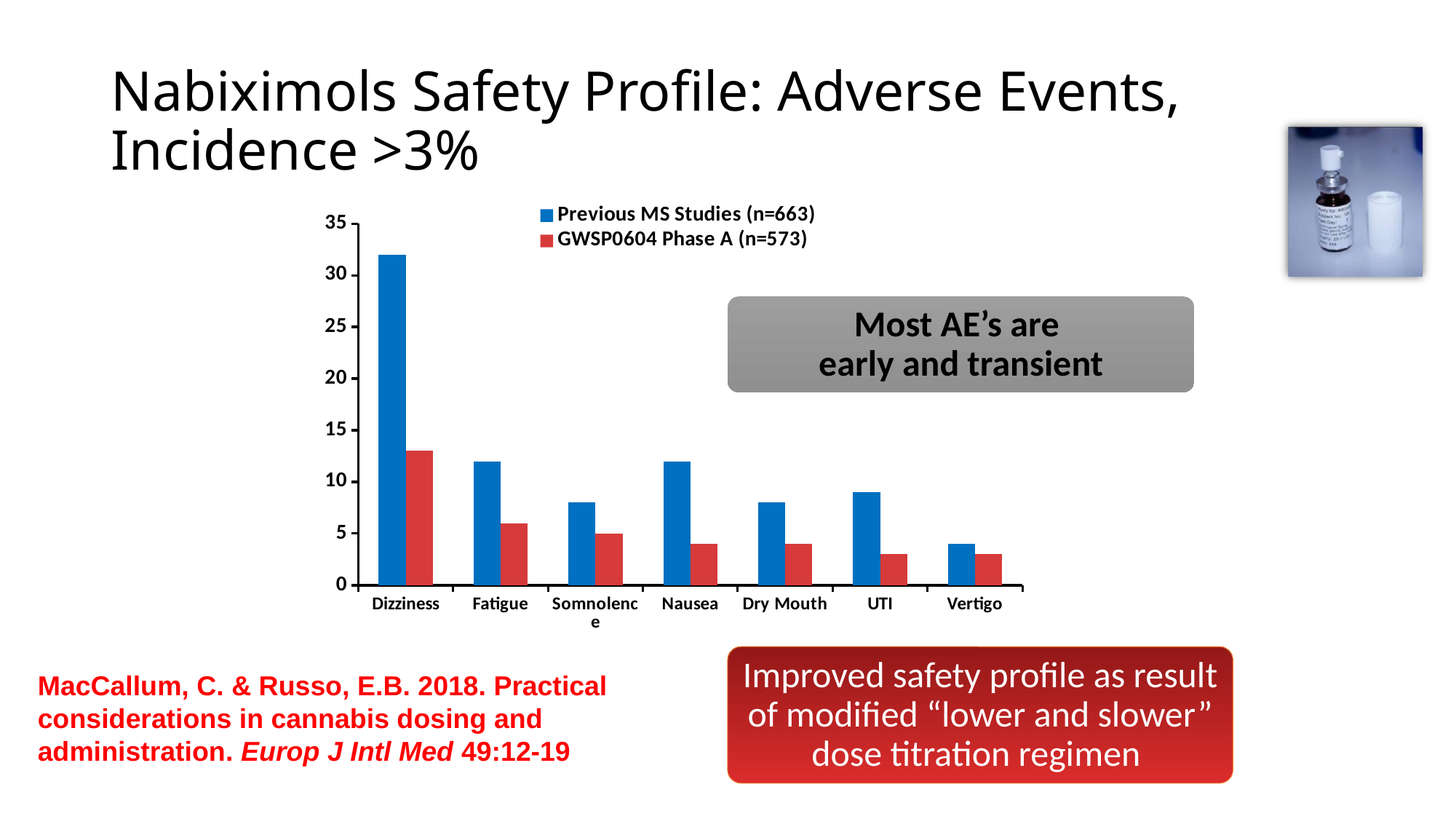
Which colour represents GWSP0604 Phase A (n=573) in the legend? red For Dizziness, which series has the larger value: Previous MS Studies (n=663) or GWSP0604 Phase A (n=573)? Previous MS Studies (n=663) Is the value for Dizziness in GWSP0604 Phase A (n=573) greater or less than 10? greater Which adverse event has the lowest value for Previous MS Studies (n=663)? Vertigo What kind of chart is shown on the slide? bar chart How many series does the legend list? 2 Which adverse event has the highest value for Previous MS Studies (n=663)? Dizziness Is the value for Somnolence in Previous MS Studies (n=663) greater or less than 10? less Is the value for Dizziness in Previous MS Studies (n=663) greater or less than 30? greater How many adverse event categories are shown on the x axis? 7 Which adverse event has the highest value for GWSP0604 Phase A (n=573)? Dizziness